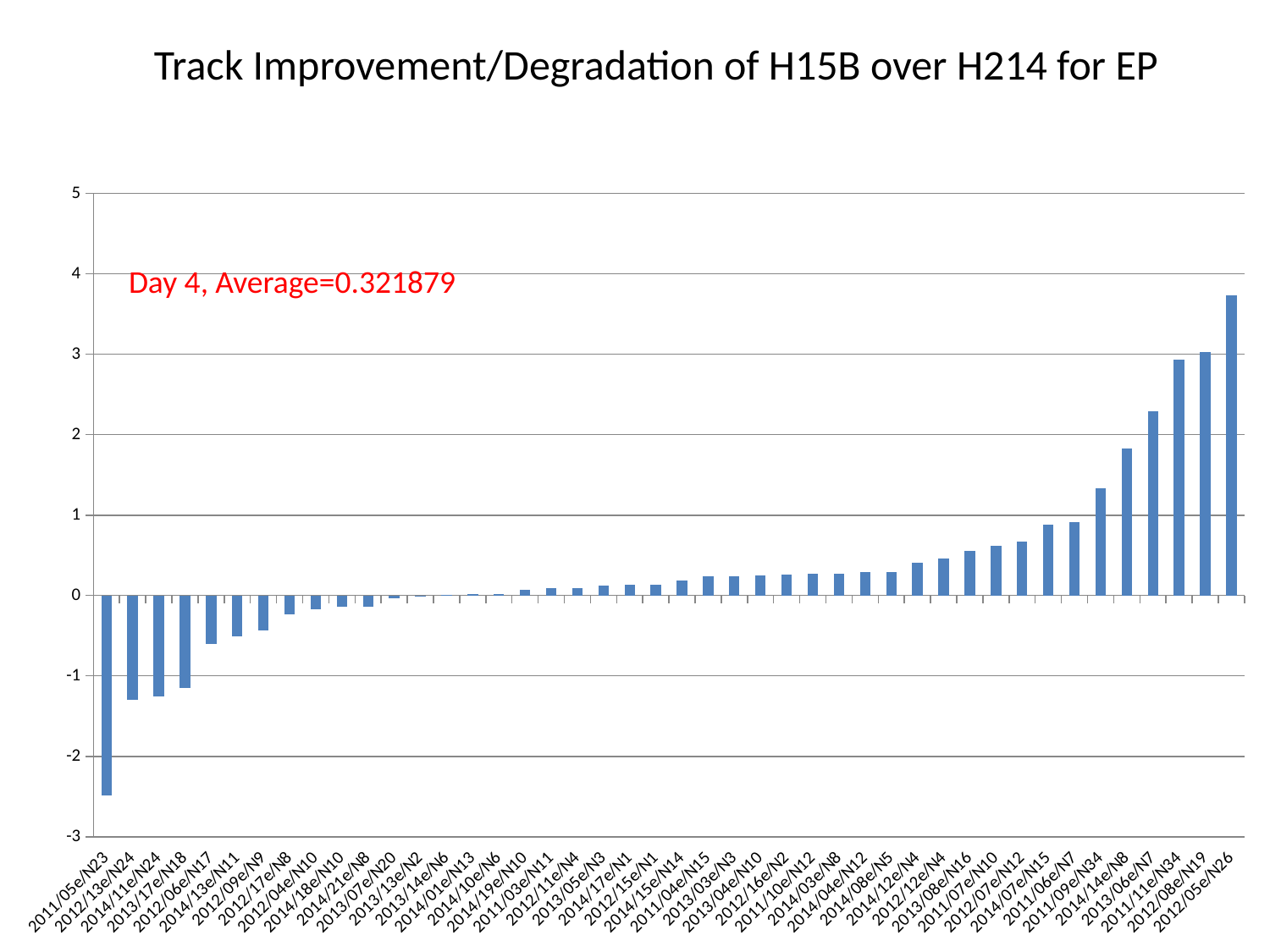
Is the value for 2012/13e/N24 greater or less than -1? less Which category has the lowest value? 2011/05e/N23 Do the bar values rise or fall from left to right along the x axis? rise What average value is stated in the red annotation on the chart? 0.321879 Which category has the highest value? 2012/05e/N26 Is the value for 2012/05e/N26 greater or less than 3? greater Is the value for 2013/06e/N7 greater or less than 2? greater What kind of chart is shown on the slide? bar chart How many categories are plotted on the x axis? 44 Which has the larger value, 2014/14e/N8 or 2013/06e/N7? 2013/06e/N7